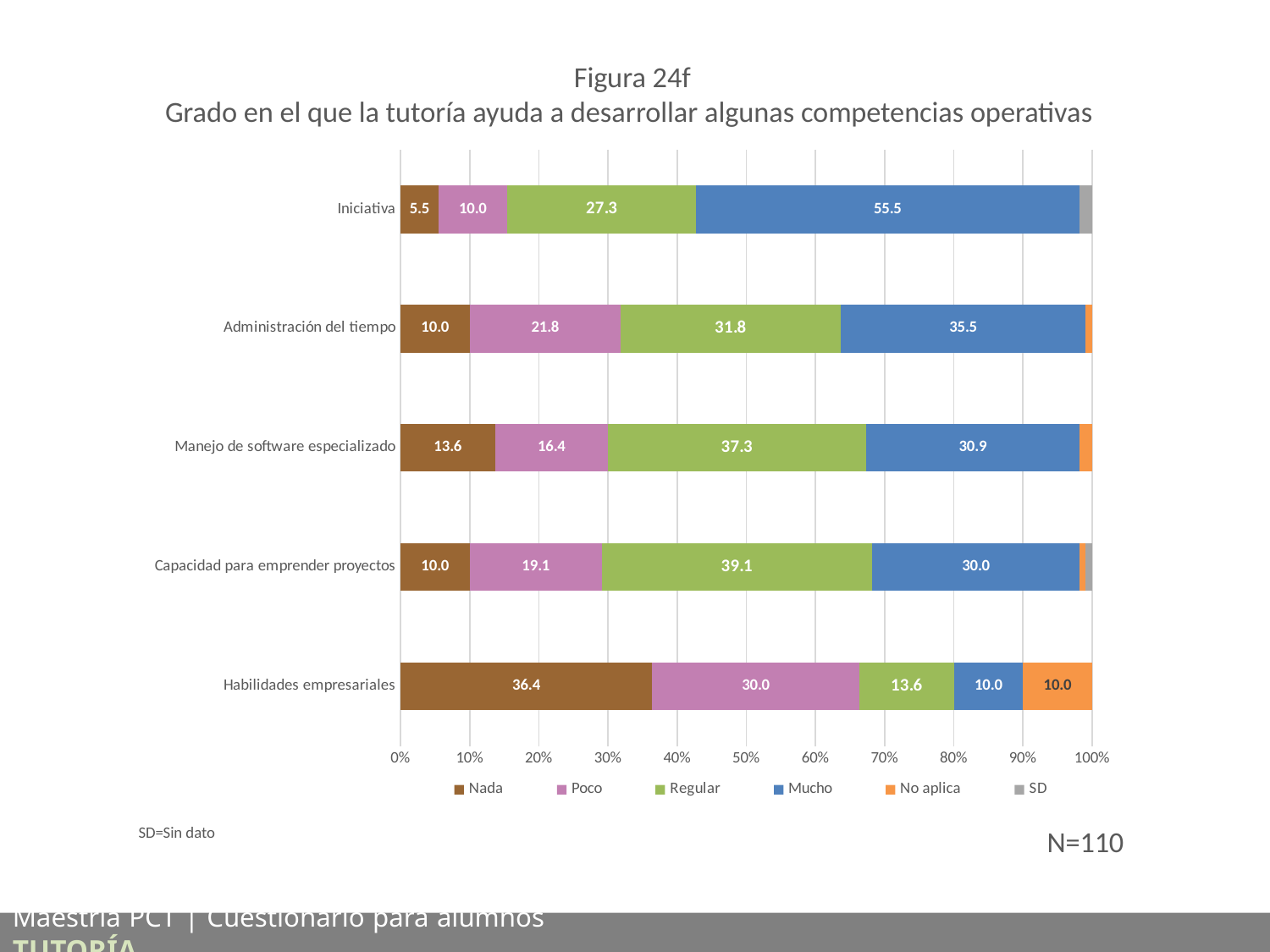
What is the value for "Regular" in the Manejo de software especializado bar? 37.3 What kind of chart is shown on the slide? Stacked bar chart Which category has the highest value for "Mucho"? Iniciativa What is the value for "Poco" in the Administración del tiempo bar? 21.8 What is the total of the Habilidades empresariales stacked bar? 100.0 Which category has the lowest value for "Nada"? Iniciativa What is the value for "Nada" in the Habilidades empresariales bar? 36.4 What is the difference between the "Mucho" values for Iniciativa and Administración del tiempo? 20.0 What is the value for "Mucho" in the Iniciativa bar? 55.5 Which is larger: the "Regular" value for Capacidad para emprender proyectos or for Manejo de software especializado? Capacidad para emprender proyectos How many series does the legend list? 6 How many categories (competencies) are shown on the chart? 5